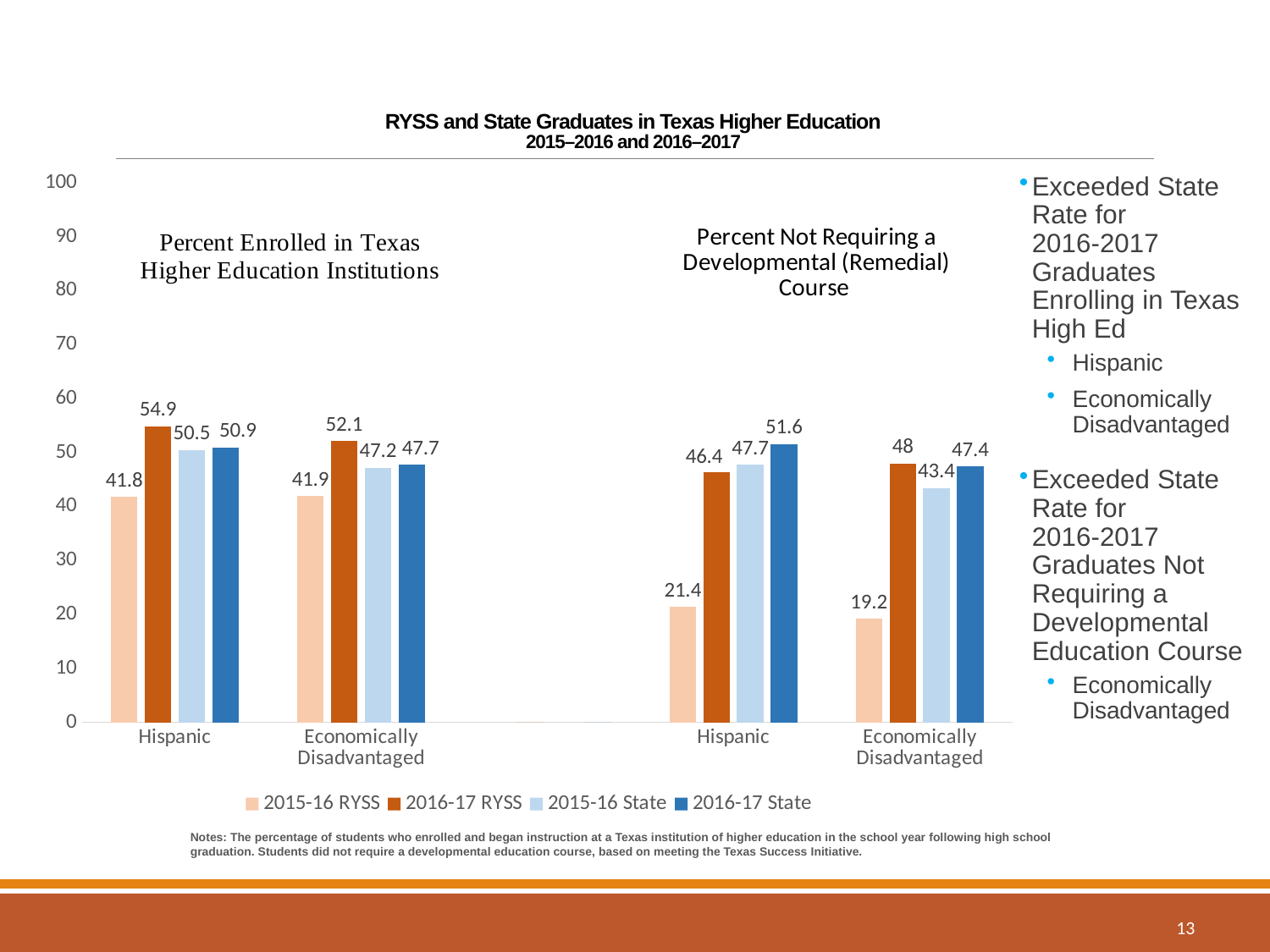
How many series does the legend list? 4 In the 'Percent Enrolled in Texas Higher Education Institutions' section, is the 2015-16 RYSS value for Hispanic greater or less than 50? less In the 'Percent Not Requiring a Developmental (Remedial) Course' section, what is the 2015-16 RYSS value for Economically Disadvantaged? 19.2 In the 'Percent Enrolled in Texas Higher Education Institutions' section, what is the difference between the 2016-17 RYSS and 2016-17 State values for Hispanic? 4 In the 'Percent Not Requiring a Developmental (Remedial) Course' section, what is the 2016-17 State value for Hispanic? 51.6 In the 'Percent Not Requiring a Developmental (Remedial) Course' section, which series has the lowest value for Hispanic? 2015-16 RYSS What kind of chart is shown on the slide? bar chart In the 'Percent Enrolled in Texas Higher Education Institutions' section, which series has the highest value for Economically Disadvantaged? 2016-17 RYSS In the 'Percent Not Requiring a Developmental (Remedial) Course' section, what is the difference between the 2016-17 RYSS and 2015-16 RYSS values for Economically Disadvantaged? 28.8 In the 'Percent Not Requiring a Developmental (Remedial) Course' section, which is larger for Hispanic: 2016-17 RYSS or 2016-17 State? 2016-17 State In the 'Percent Enrolled in Texas Higher Education Institutions' section, what is the 2016-17 RYSS value for Hispanic? 54.9 What is the title of the chart? RYSS and State Graduates in Texas Higher Education 2015–2016 and 2016–2017